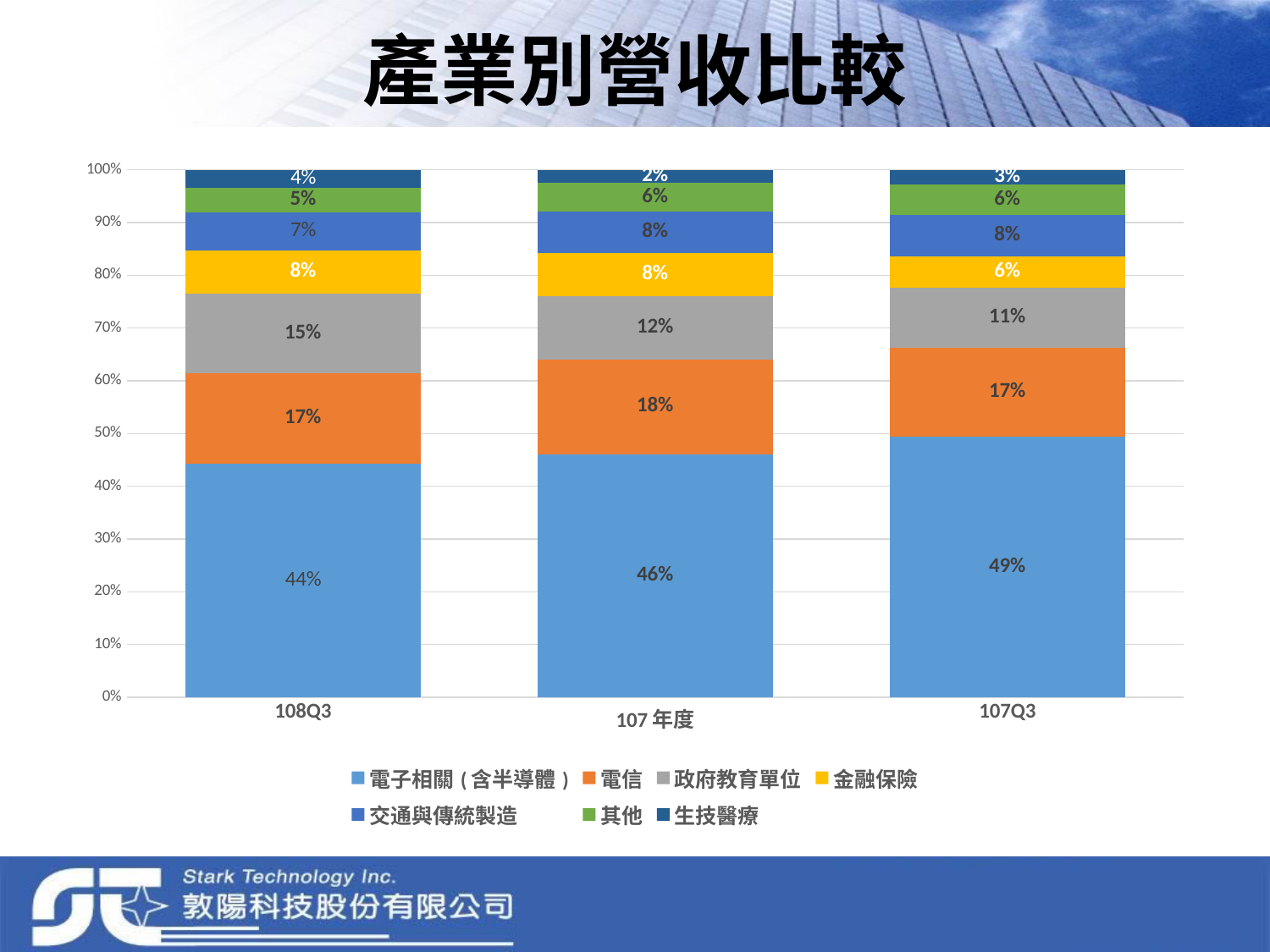
Which is larger: 金融保險 in 108Q3 or 金融保險 in 107Q3? 108Q3 What is the difference between the 電子相關（含半導體） values for 107Q3 and 108Q3? 5% What is the value for 電信 in 107 年度? 18% What is the value for 政府教育單位 in 107Q3? 11% What is the title of the chart? 產業別營收比較 Which period has the lowest value for 政府教育單位? 107Q3 What is the value for 電子相關（含半導體） in 108Q3? 44% How many series does the legend list? 7 What is the value for 生技醫療 in 107 年度? 2% Which period has the highest value for 電子相關（含半導體）? 107Q3 What type of chart is shown on the slide? Stacked bar chart How many periods (categories) are shown on the x axis? 3